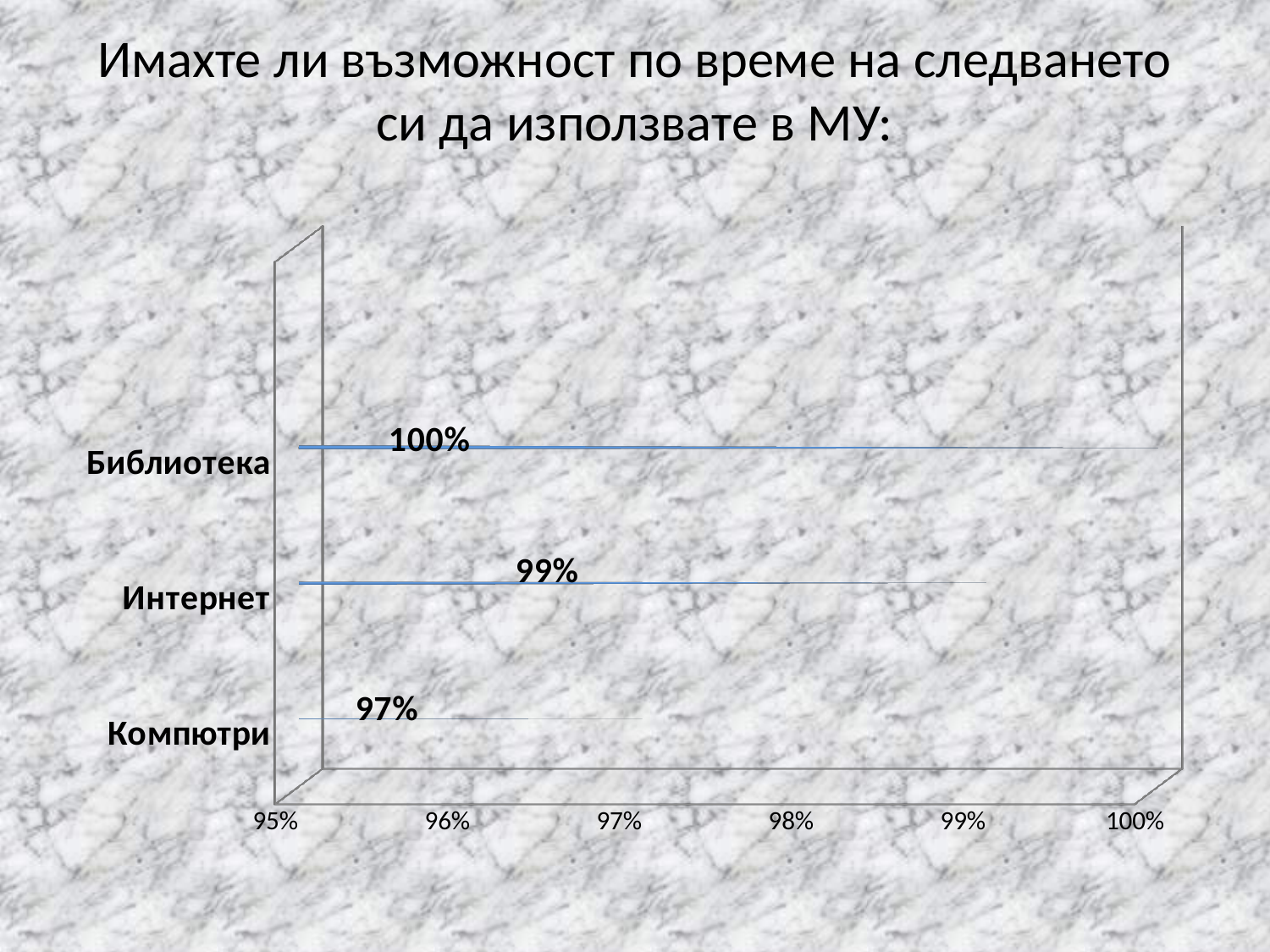
Which category has the highest value? Библиотека What is the title of the slide? Имахте ли възможност по време на следването си да използвате в МУ: What is the value for Интернет? 99% How many categories are shown in the chart? 3 What is the value for Библиотека? 100% What is the difference between the values for Интернет and Компютри? 2% Which is larger, the value for Интернет or the value for Компютри? Интернет Which category has the lowest value? Компютри Is the value for Компютри greater or less than 98%? less What is the difference between the values for Библиотека and Компютри? 3% What is the value for Компютри? 97% What kind of chart is shown on the slide? bar chart